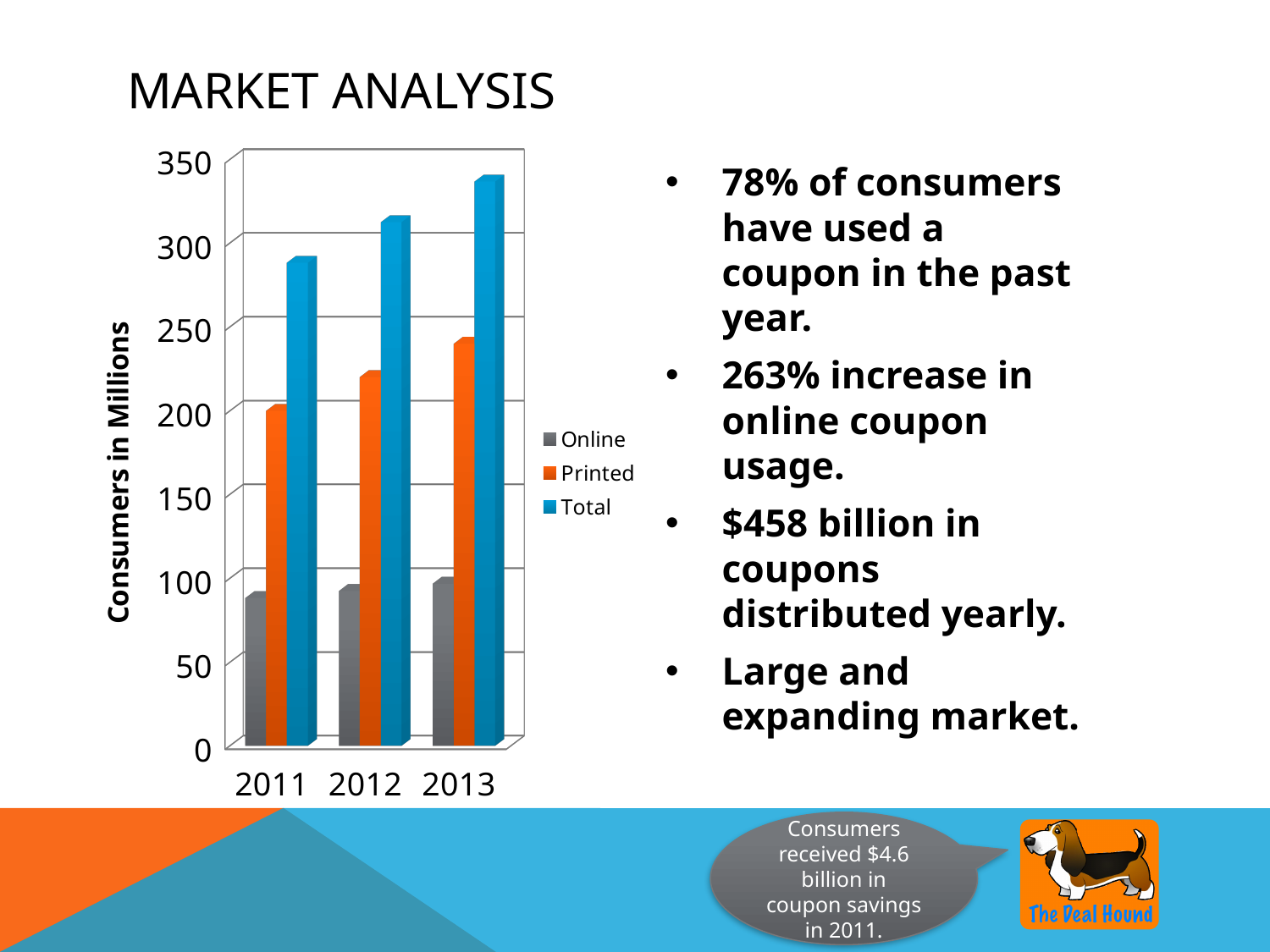
How many years are shown on the x axis of the chart? 3 What kind of chart is shown on the slide? bar chart Which year has the lowest Online value in the chart? 2011 Which year has the highest Total value in the chart? 2013 How many series does the chart's legend list? 3 Do the Total values rise or fall from 2011 to 2013? rise Is the Printed value for 2013 greater or less than 200? greater What is the title of the chart's vertical axis? Consumers in Millions Which is larger in 2013, the Printed value or the Online value? Printed Is the Total value for 2013 greater or less than 300? greater Is the Total value for 2011 greater or less than 300? less